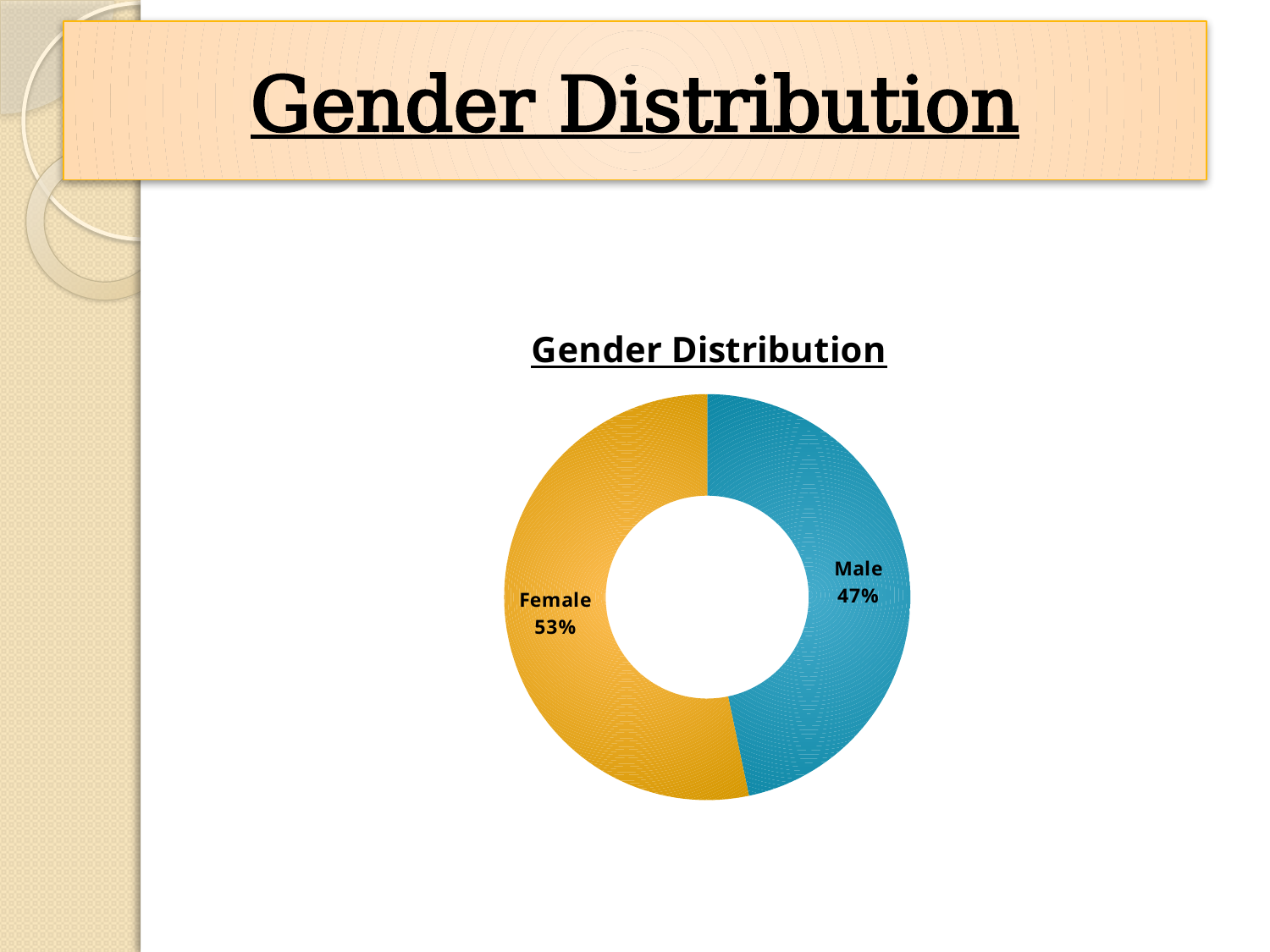
Which is larger, the Female share or the Male share? Female What percentage of the chart is Male? 47% How many categories does the chart show? 2 Which category has the largest share? Female Is the Male share greater or less than 50%? less What is the title of the chart? Gender Distribution What percentage of the chart is Female? 53% Which category has the smallest share? Male What is the total of the two percentages shown? 100% What is the difference in percentage points between Female and Male? 6 What kind of chart is shown on the slide? Doughnut (pie) chart What colour is the Female segment? Orange